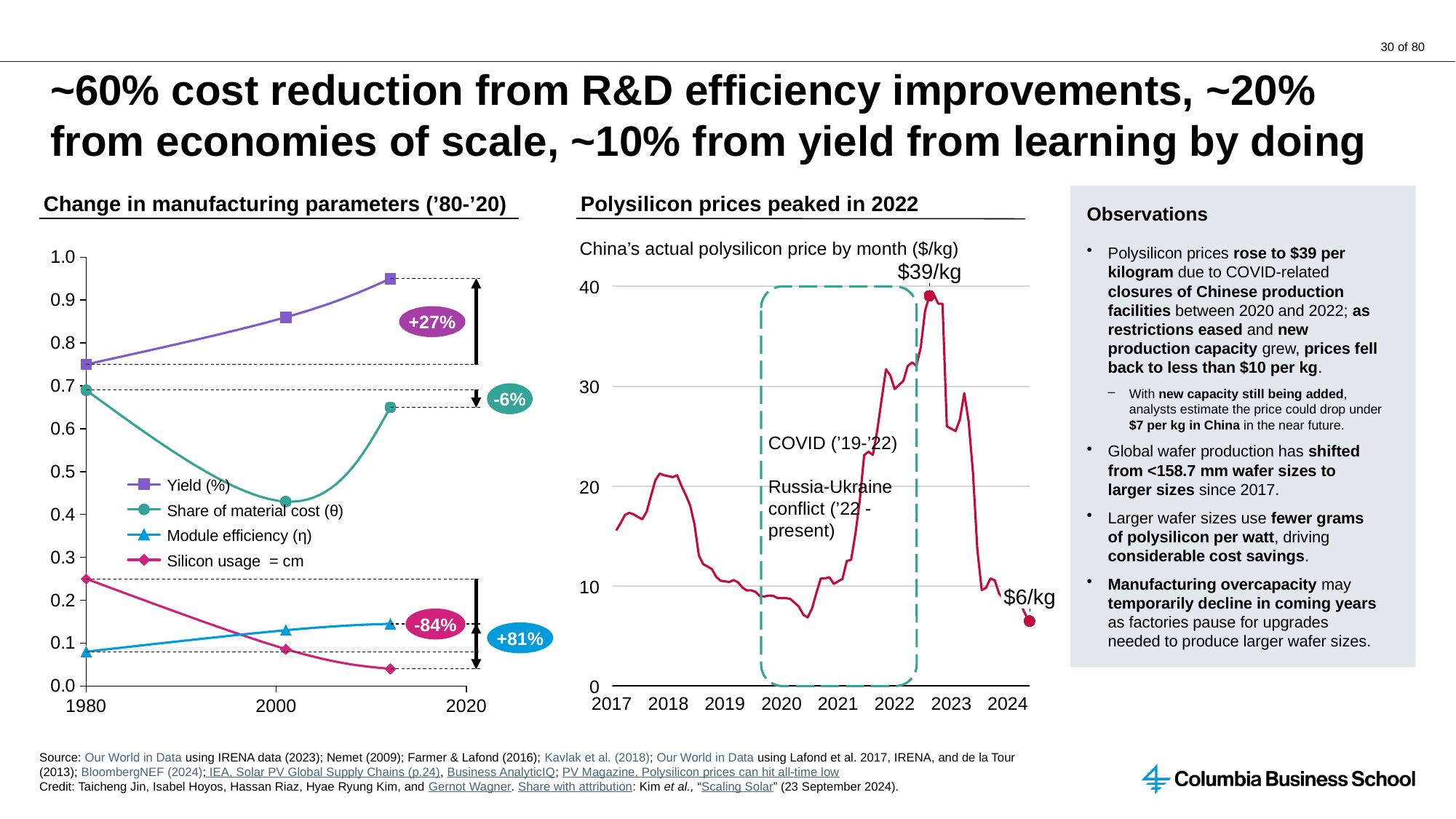
In the 'Polysilicon prices peaked in 2022' chart, what is the labelled price at the end of the series in 2024? $6/kg In the 'Change in manufacturing parameters' chart, does Silicon usage rise or fall from 1980 to its last plotted point? fall In the 'Change in manufacturing parameters' chart, what percentage change is annotated for Silicon usage? -84% In the 'Polysilicon prices peaked in 2022' chart, what period does the dashed box mark? COVID ('19-'22) In the 'Change in manufacturing parameters' chart, what percentage change is annotated for Module efficiency (η)? +81% In the 'Change in manufacturing parameters' chart, what percentage change is annotated for Yield (%)? +27% What kind of chart is the 'Polysilicon prices peaked in 2022' chart? Line chart In the 'Change in manufacturing parameters' chart, is the 1980 value for Yield (%) greater or less than 0.7? greater In the 'Polysilicon prices peaked in 2022' chart, what is the labelled peak price? $39/kg In the 'Polysilicon prices peaked in 2022' chart, what is the difference between the labelled peak price and the labelled 2024 price? $33/kg In the 'Change in manufacturing parameters' chart, which series has the highest value at its last plotted point? Yield (%) How many series does the legend of the 'Change in manufacturing parameters' chart list? 4